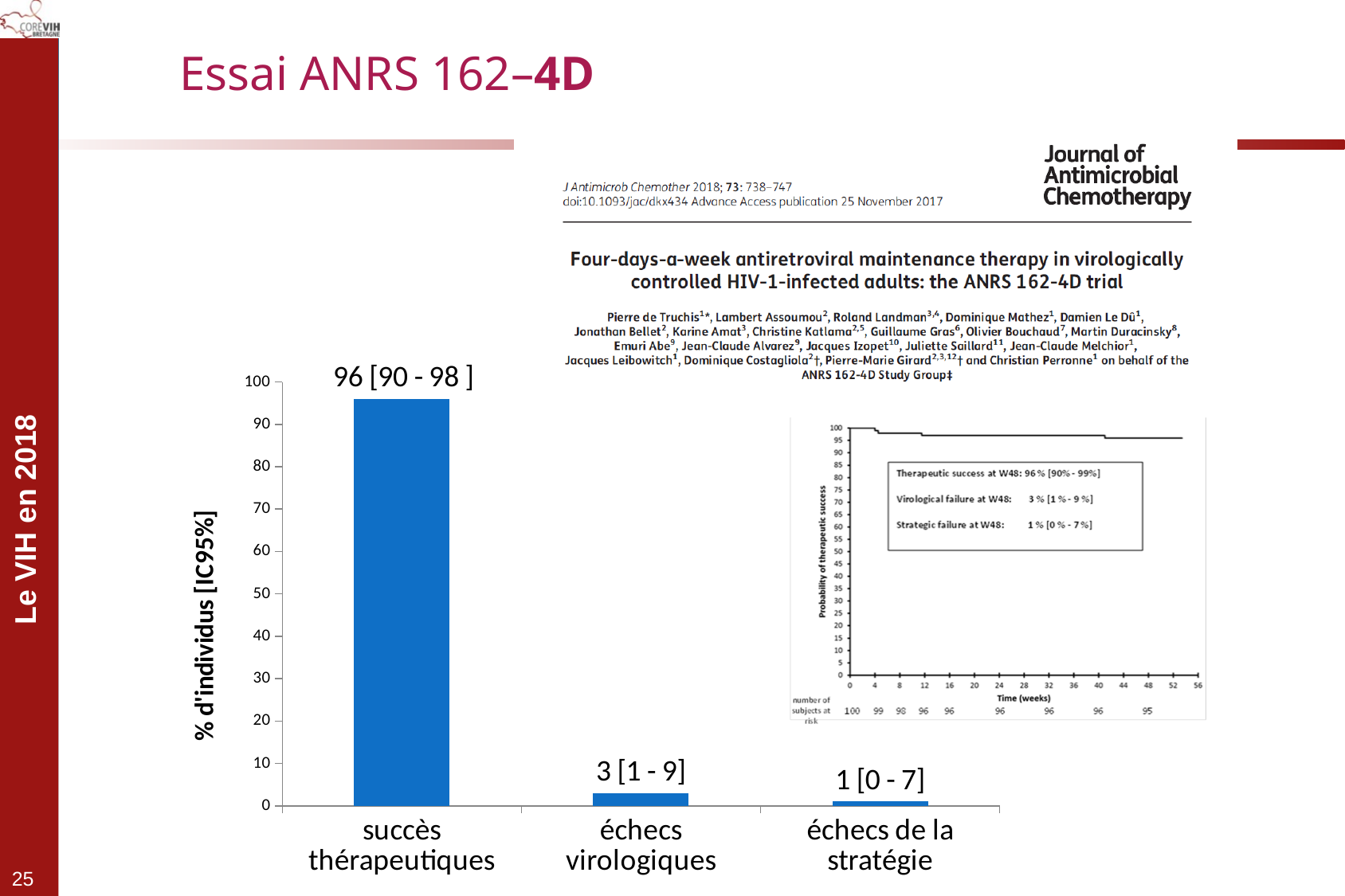
In the bar chart, what is the difference between the point estimates for 'échecs virologiques' and 'échecs de la stratégie'? 2 In the bar chart, what is the value shown for 'échecs de la stratégie'? 1 [0 - 7] What kind of chart is the chart on the left of the slide? bar chart In the bar chart, what is the value shown for 'échecs virologiques'? 3 [1 - 9] How many categories are shown in the bar chart? 3 What is the label of the vertical axis of the bar chart? % d'individus [IC95%] In the bar chart, what is the value shown for 'succès thérapeutiques'? 96 [90 - 98 ] In the bar chart, is the value for 'succès thérapeutiques' greater or less than 90? greater In the bar chart, which category has the lowest value? échecs de la stratégie In the bar chart, what is the difference between the point estimates for 'succès thérapeutiques' and 'échecs virologiques'? 93 In the bar chart, which category has the highest value? succès thérapeutiques In the bar chart, which is larger: the value for 'échecs virologiques' or for 'échecs de la stratégie'? échecs virologiques